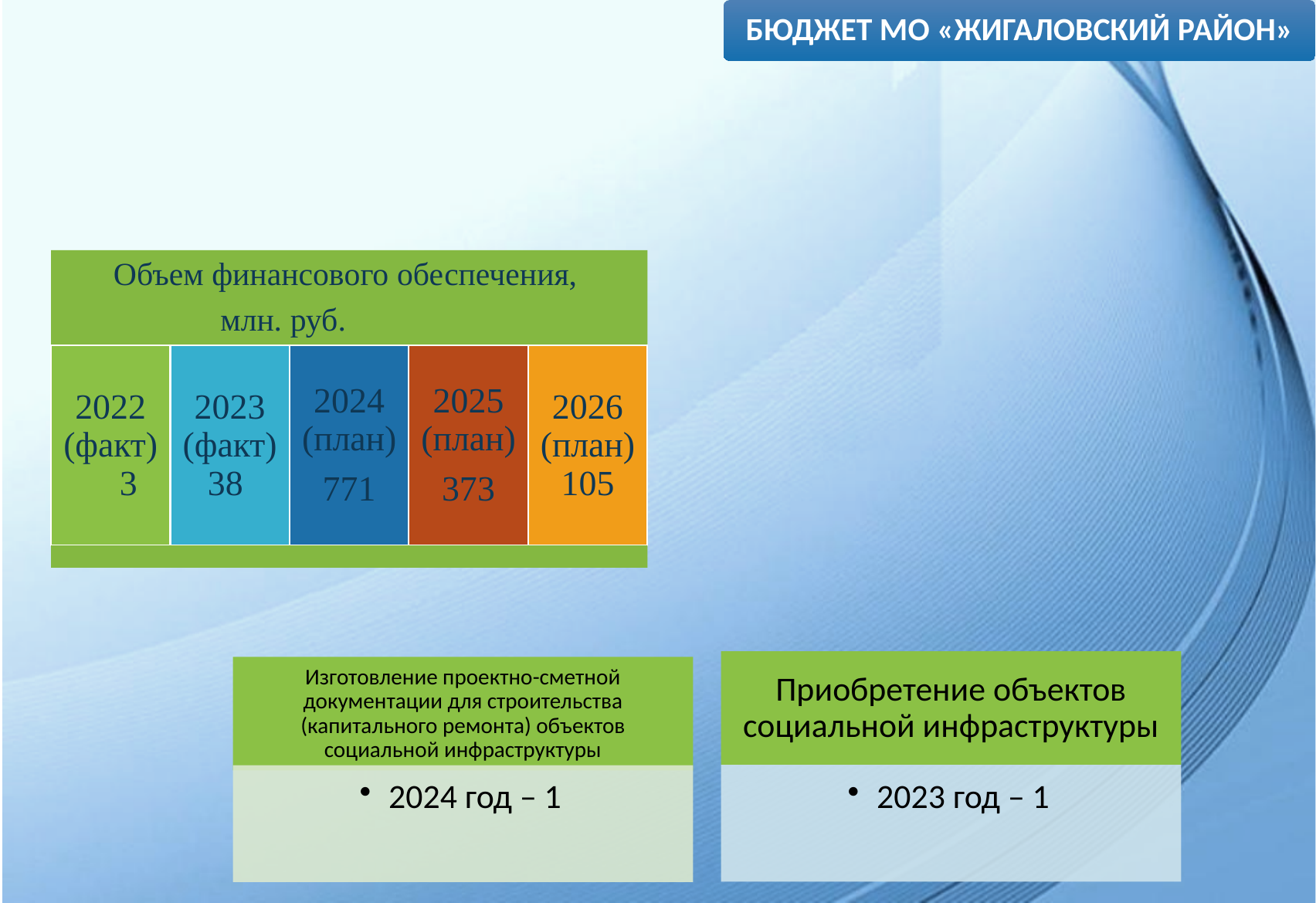
Which year has the lowest value in the 'Объем финансового обеспечения, млн. руб.' graphic? 2022 (факт) In the 'Объем финансового обеспечения, млн. руб.' graphic, what is the difference between the 2023 (факт) and 2022 (факт) values? 35 In the 'Объем финансового обеспечения, млн. руб.' graphic, which is larger: the value for 2025 (план) or 2026 (план)? 2025 (план) What is the value for 2023 (факт) in the 'Объем финансового обеспечения, млн. руб.' graphic? 38 In the 'Объем финансового обеспечения, млн. руб.' graphic, what colour is the block for 2025 (план)? Orange-brown What is the value for 2024 (план) in the 'Объем финансового обеспечения, млн. руб.' graphic? 771 How many years are shown in the 'Объем финансового обеспечения, млн. руб.' graphic? 5 What is the value for 2022 (факт) in the 'Объем финансового обеспечения, млн. руб.' graphic? 3 Which year has the highest value in the 'Объем финансового обеспечения, млн. руб.' graphic? 2024 (план) What unit is stated in the title of the 'Объем финансового обеспечения' graphic? млн. руб. In the 'Объем финансового обеспечения, млн. руб.' graphic, what is the difference between the 2024 (план) and 2025 (план) values? 398 What is the value for 2026 (план) in the 'Объем финансового обеспечения, млн. руб.' graphic? 105